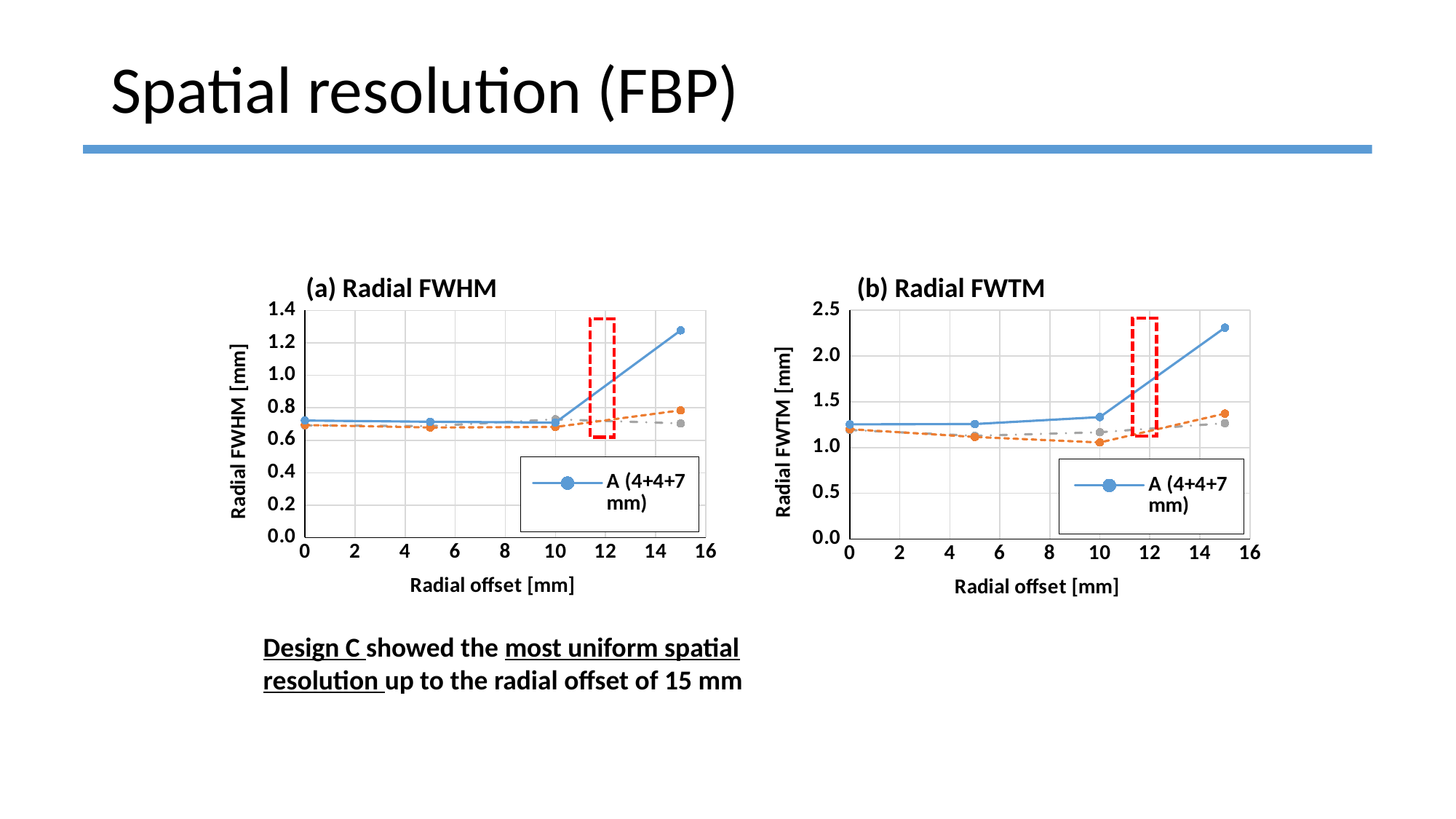
In the chart titled "(a) Radial FWHM", how many data points are plotted for series A (4+4+7 mm)? 4 In the chart titled "(a) Radial FWHM", at a radial offset of 15 mm, which is larger: the value for series A (4+4+7 mm) or the value for the orange dashed series? A (4+4+7 mm) In the chart titled "(a) Radial FWHM", at which radial offset does series A (4+4+7 mm) reach its highest value? 15 mm What is the x-axis label of the chart titled "(b) Radial FWTM"? Radial offset [mm] In the chart titled "(a) Radial FWHM", is the value for series A (4+4+7 mm) at a radial offset of 15 mm greater or less than 1.2? greater In the chart titled "(b) Radial FWTM", is the value for series A (4+4+7 mm) at a radial offset of 15 mm greater or less than 2.0? greater Which series name is shown in the legend of the chart titled "(a) Radial FWHM"? A (4+4+7 mm) In the chart titled "(a) Radial FWHM", is the value for series A (4+4+7 mm) at a radial offset of 0 mm greater or less than 0.6? greater What kind of chart is the chart titled "(a) Radial FWHM"? line chart In the chart titled "(b) Radial FWTM", does the value for series A (4+4+7 mm) rise or fall between radial offsets of 10 mm and 15 mm? rise